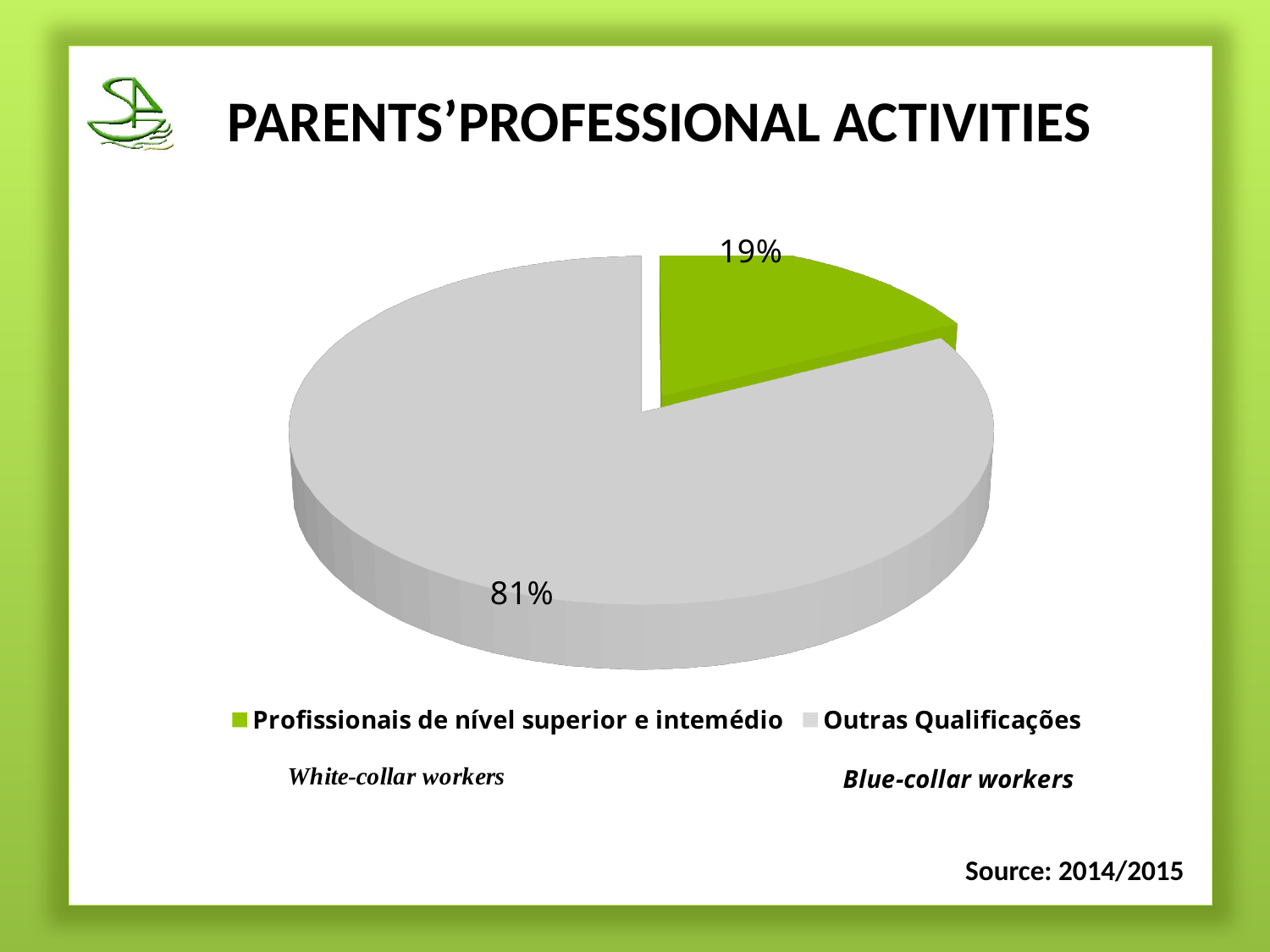
How many entries does the legend list? 2 What percentage of the pie is labelled for 'Outras Qualificações'? 81% What share of the pie does the green slice represent? 19% What percentage of the pie is labelled for 'Profissionais de nível superior e intemédio'? 19% What is the title of the slide? PARENTS'PROFESSIONAL ACTIVITIES Which is larger: the share for 'Outras Qualificações' or the share for 'Profissionais de nível superior e intemédio'? Outras Qualificações What colour is the slice for 'Profissionais de nível superior e intemédio'? Green What is the difference in percentage points between the 'Outras Qualificações' slice and the 'Profissionais de nível superior e intemédio' slice? 62 Which category has the smallest share of the pie? Profissionais de nível superior e intemédio How many slices does the pie chart have? 2 What kind of chart is shown on the slide? Pie chart Which category has the largest share of the pie? Outras Qualificações